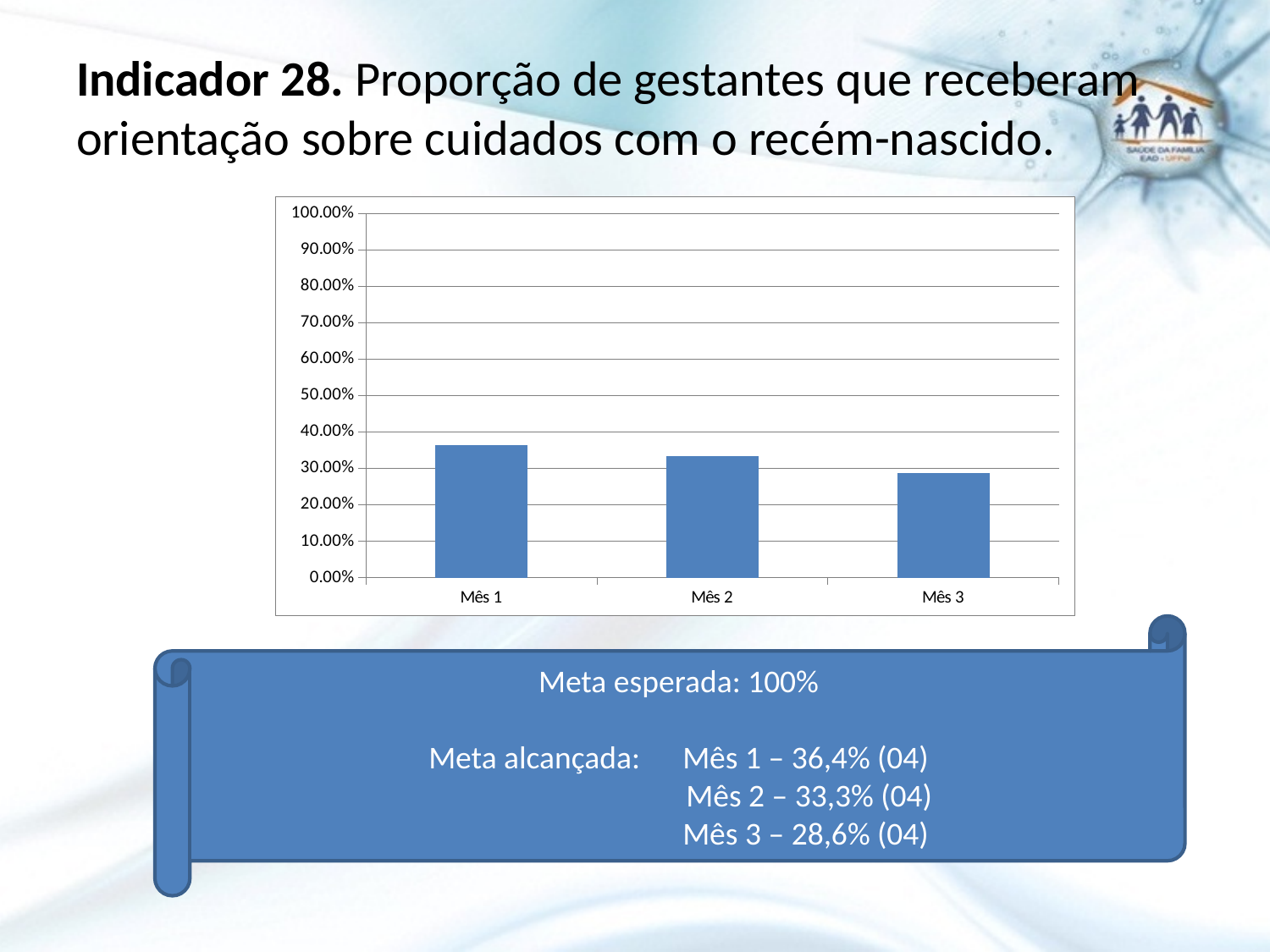
How many categories (months) are plotted on the chart? 3 Is the value for Mês 1 greater or less than 30.00%? greater Is the value for Mês 3 greater or less than 30.00%? less According to the text on the slide, what value was reached in Mês 1? 36,4% Is the value for Mês 1 greater or less than 40.00%? less Do the values rise or fall from Mês 1 to Mês 3? fall What kind of chart is shown on the slide? bar chart According to the text on the slide, what value was reached in Mês 3? 28,6% Which is larger, the value for Mês 2 or the value for Mês 3? Mês 2 Which month has the lowest bar on the chart? Mês 3 What is the highest value shown on the chart's vertical axis? 100.00% Which month has the highest bar on the chart? Mês 1